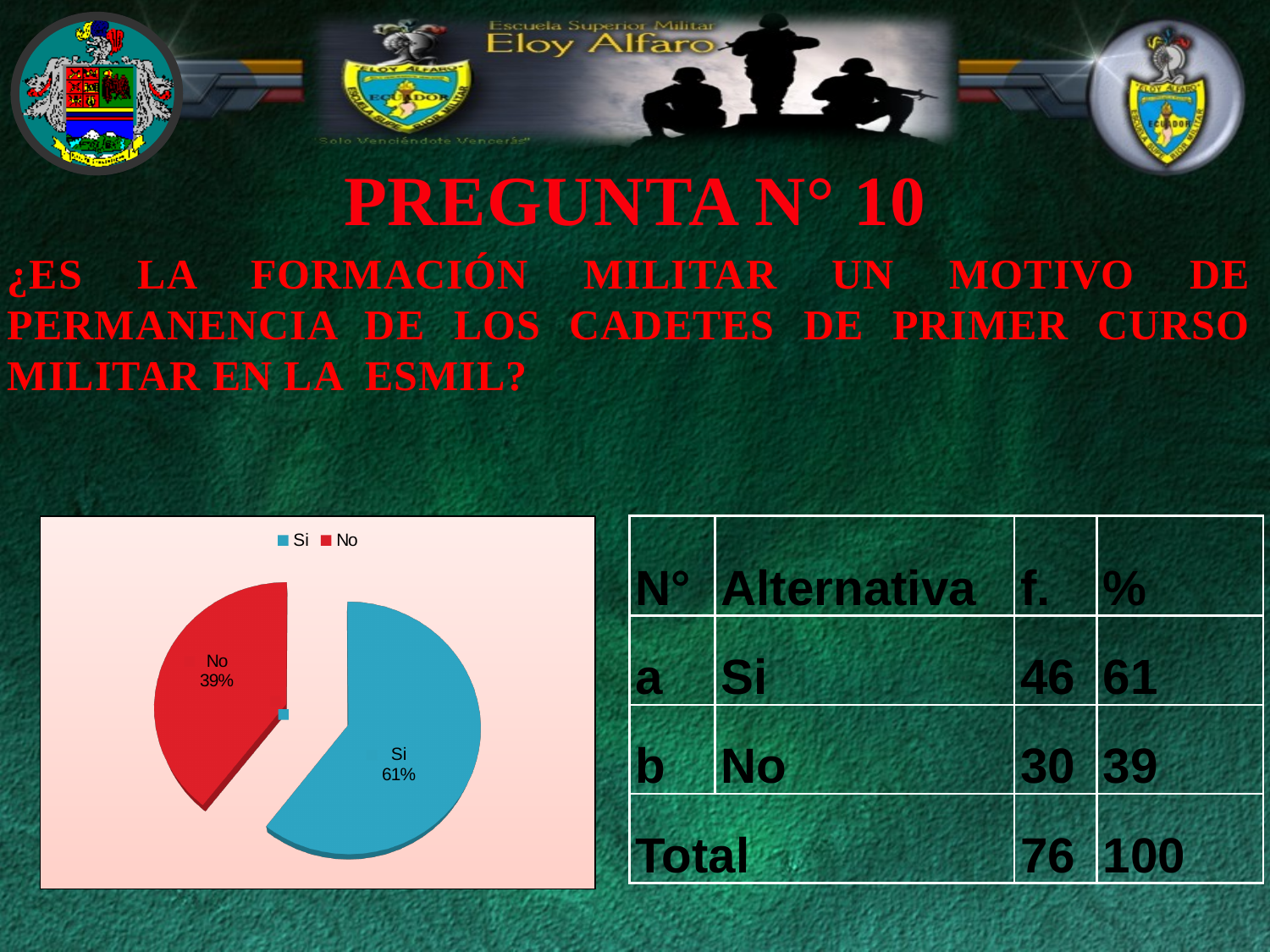
Which is larger in the pie chart, Si or No? Si What colour is the Si slice in the pie chart? blue What percentage does the No slice show in the pie chart? 39% Which slice of the pie chart is the largest? Si How many slices does the pie chart have? 2 Is the share of the Si slice greater or less than 50%? greater What colour is the No slice in the pie chart? red What is the difference in percentage points between the Si and No slices? 22 Which slice of the pie chart is the smallest? No What kind of chart is shown on the slide? pie chart How many entries does the legend of the pie chart list? 2 What percentage does the Si slice show in the pie chart? 61%